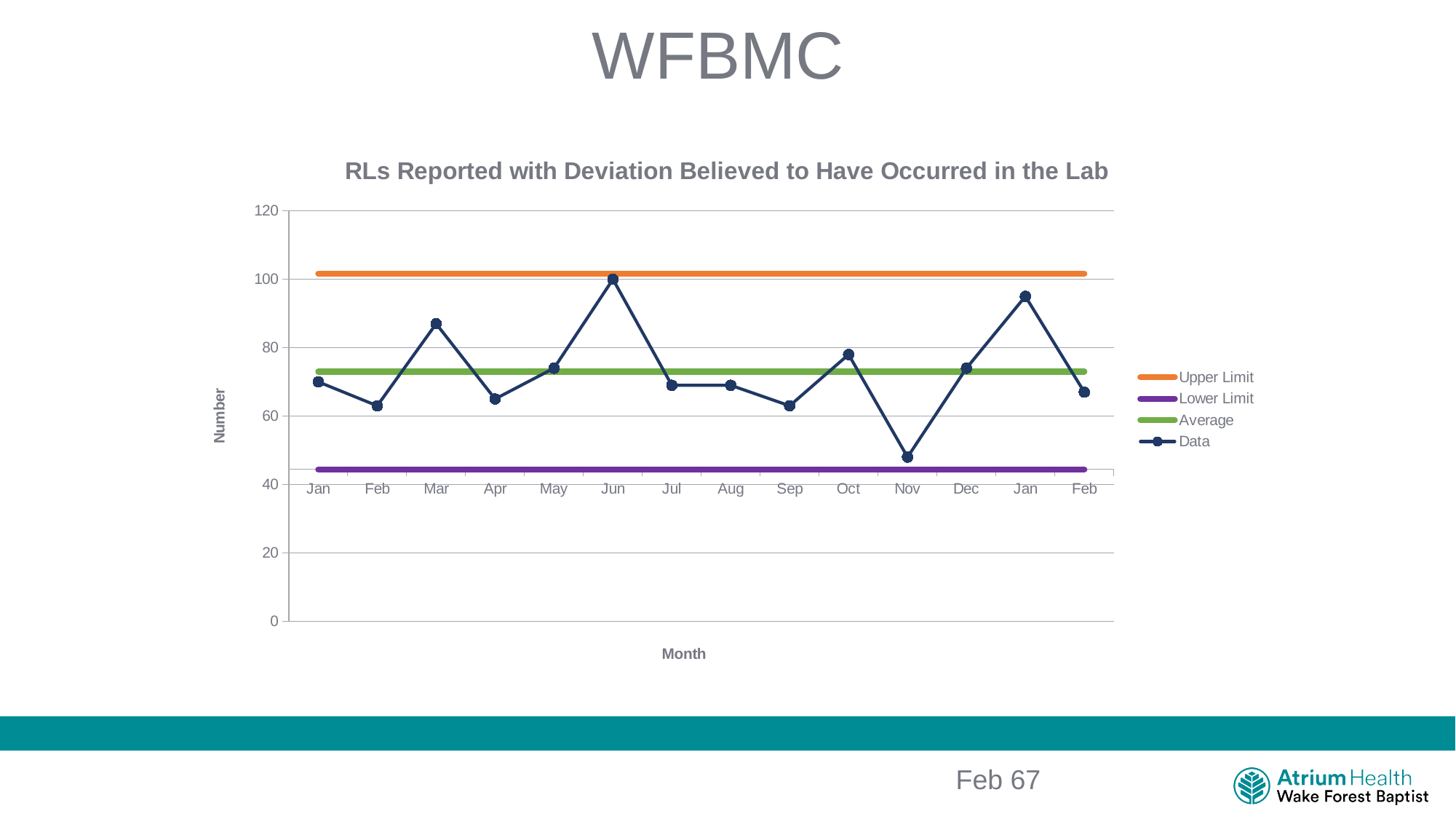
Which month has the larger Data value, Oct or Sep? Oct What is the title of the chart? RLs Reported with Deviation Believed to Have Occurred in the Lab In which month does the Data series reach its highest value? Jun Which legend entry is shown in green? Average How many series does the legend list? 4 Is the Upper Limit line above or below 100? above How many months are plotted along the x axis? 14 What kind of chart is shown on the slide? line chart Is the Data value for Mar greater or less than 80? greater Is the Lower Limit line greater or less than 60? less In which month does the Data series reach its lowest value? Nov